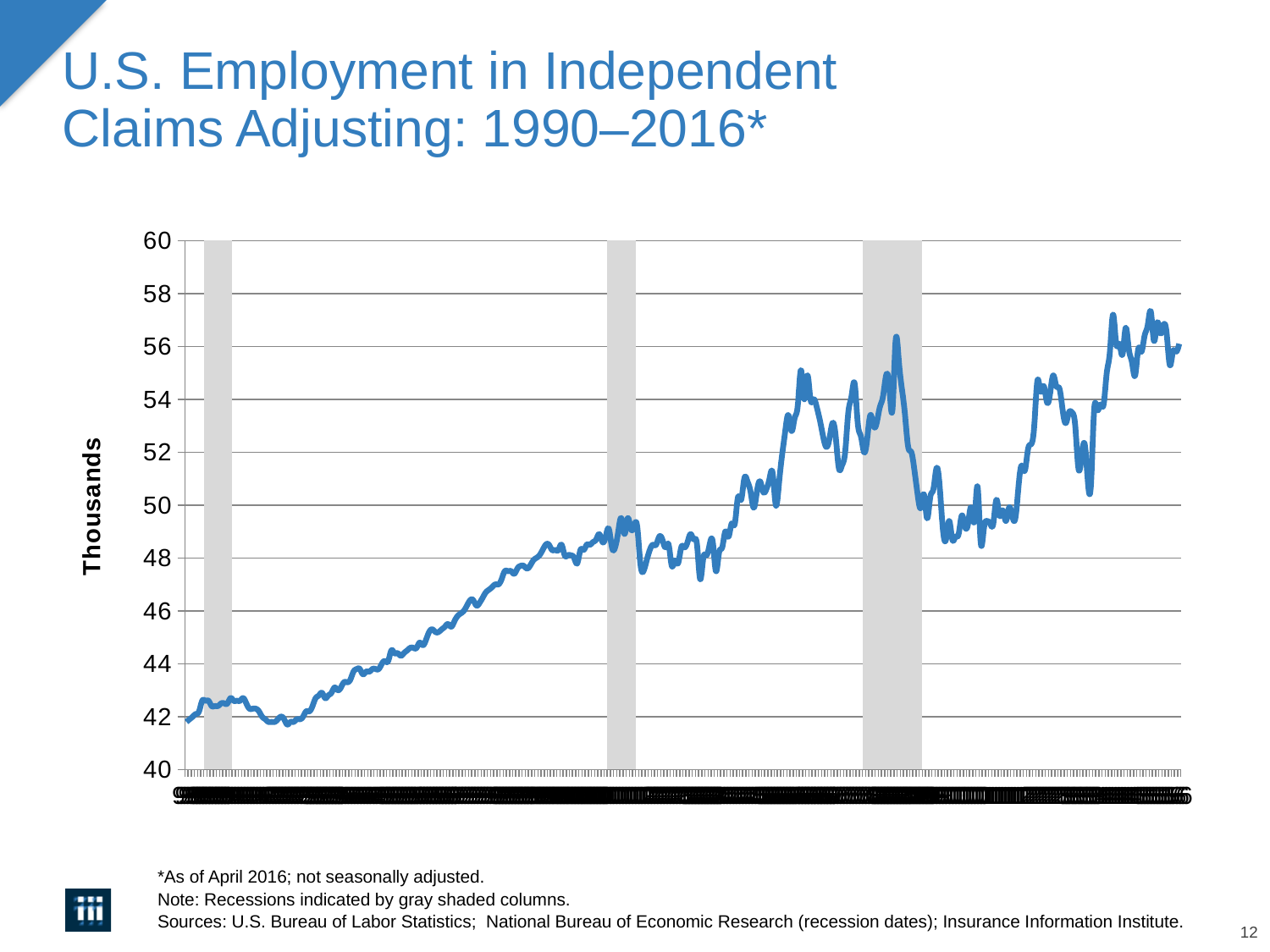
What kind of chart is shown on the slide? line chart Does the line ever rise above 58 on the chart? No Overall, do the values rise or fall from the left of the chart (1990) to the right (2016)? rise Does the line ever fall below 42 on the chart? Yes How many gray shaded recession columns appear on the chart? 3 What is the label on the vertical axis of the chart? Thousands Is the value at the start of the series (1990) greater or less than 40? greater